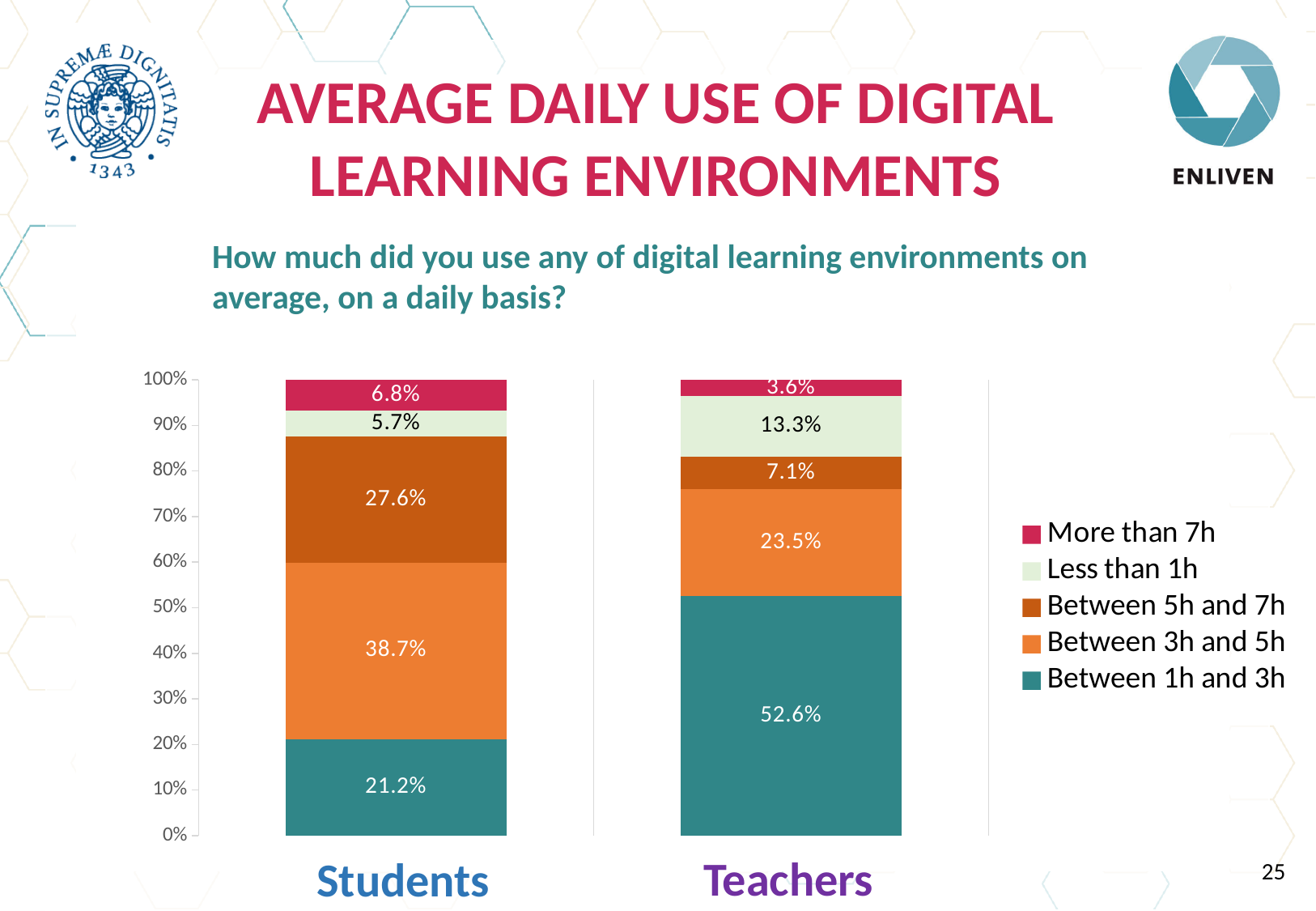
What percentage of teachers reported using digital learning environments between 1h and 3h daily? 52.6% What percentage of students reported using digital learning environments between 3h and 5h daily? 38.7% Which colour represents 'Between 1h and 3h' in the legend? Teal Which usage category has the smallest share among teachers? More than 7h What type of chart is shown on the slide? Stacked bar chart Which group has a larger share for 'Between 5h and 7h', students or teachers? Students Which usage category has the largest share among students? Between 3h and 5h What is the difference between the 'Between 1h and 3h' share for teachers and for students? 31.4% How many series does the legend list? 5 What is the value for 'Less than 1h' in the Teachers bar? 13.3% What is the value for 'More than 7h' in the Students bar? 6.8% How many groups (bars) are shown on the chart? 2